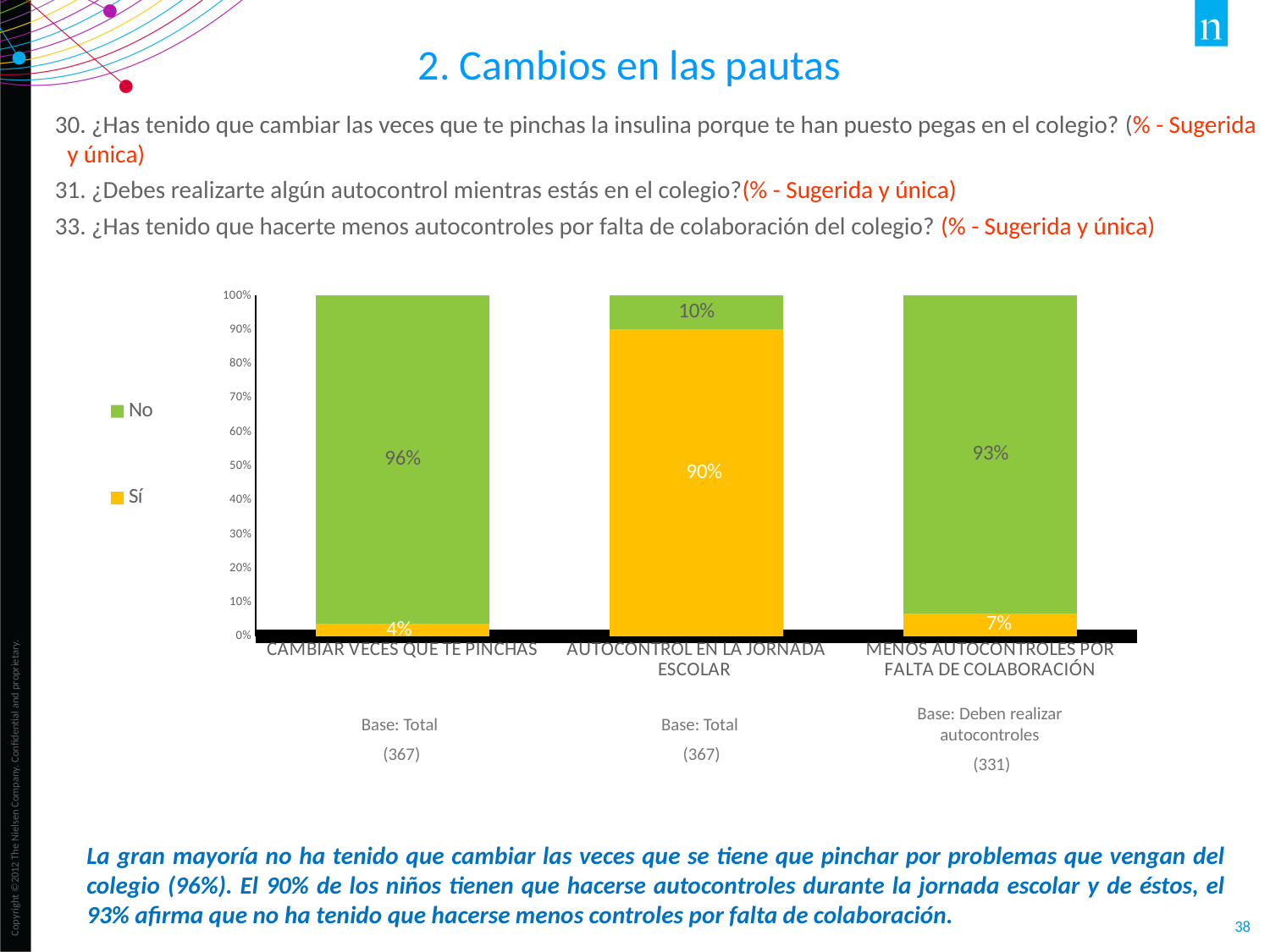
What is the value of the "Sí" series for "AUTOCONTROL EN LA JORNADA ESCOLAR"? 90% Which is larger: the "Sí" value for "MENOS AUTOCONTROLES POR FALTA DE COLABORACIÓN" or the "Sí" value for "CAMBIAR VECES QUE TE PINCHAS"? MENOS AUTOCONTROLES POR FALTA DE COLABORACIÓN What is the value of the "Sí" series for "CAMBIAR VECES QUE TE PINCHAS"? 4% How many categories are shown on the x axis of the chart? 3 Which category has the highest "Sí" value? AUTOCONTROL EN LA JORNADA ESCOLAR Which category has the lowest "No" value? AUTOCONTROL EN LA JORNADA ESCOLAR What is the value of the "No" series for "MENOS AUTOCONTROLES POR FALTA DE COLABORACIÓN"? 93% What kind of chart is shown on the slide? Stacked bar chart What is the difference between the "No" value for "CAMBIAR VECES QUE TE PINCHAS" and the "No" value for "MENOS AUTOCONTROLES POR FALTA DE COLABORACIÓN"? 3% What is the total of the stacked bar for "AUTOCONTROL EN LA JORNADA ESCOLAR"? 100% How many series does the chart legend list? 2 What is the value of the "No" series for "CAMBIAR VECES QUE TE PINCHAS"? 96%